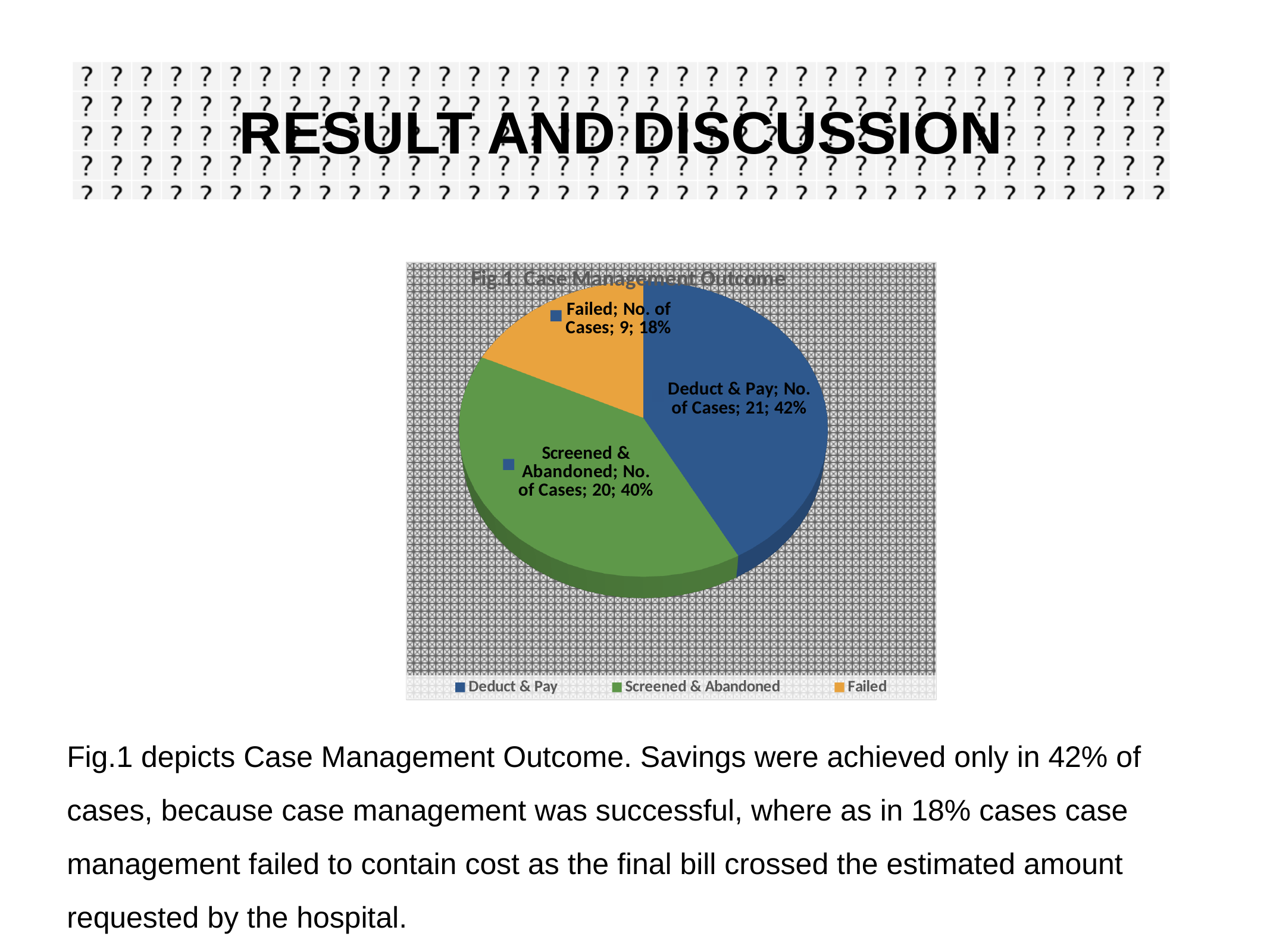
What is the title of the chart? Fig.1. Case Management Outcome What share of the pie does the Screened & Abandoned slice represent? 40% How many cases are in the Deduct & Pay category? 21 How many cases are in the Failed category? 9 What share of the pie does the Deduct & Pay slice represent? 42% Which category has the most cases? Deduct & Pay How many cases are in the Screened & Abandoned category? 20 How many categories does the pie chart show? 3 Which category has the fewest cases? Failed What share of the pie does the Failed slice represent? 18% What kind of chart is shown on the slide? Pie chart What is the difference in number of cases between Deduct & Pay and Failed? 12